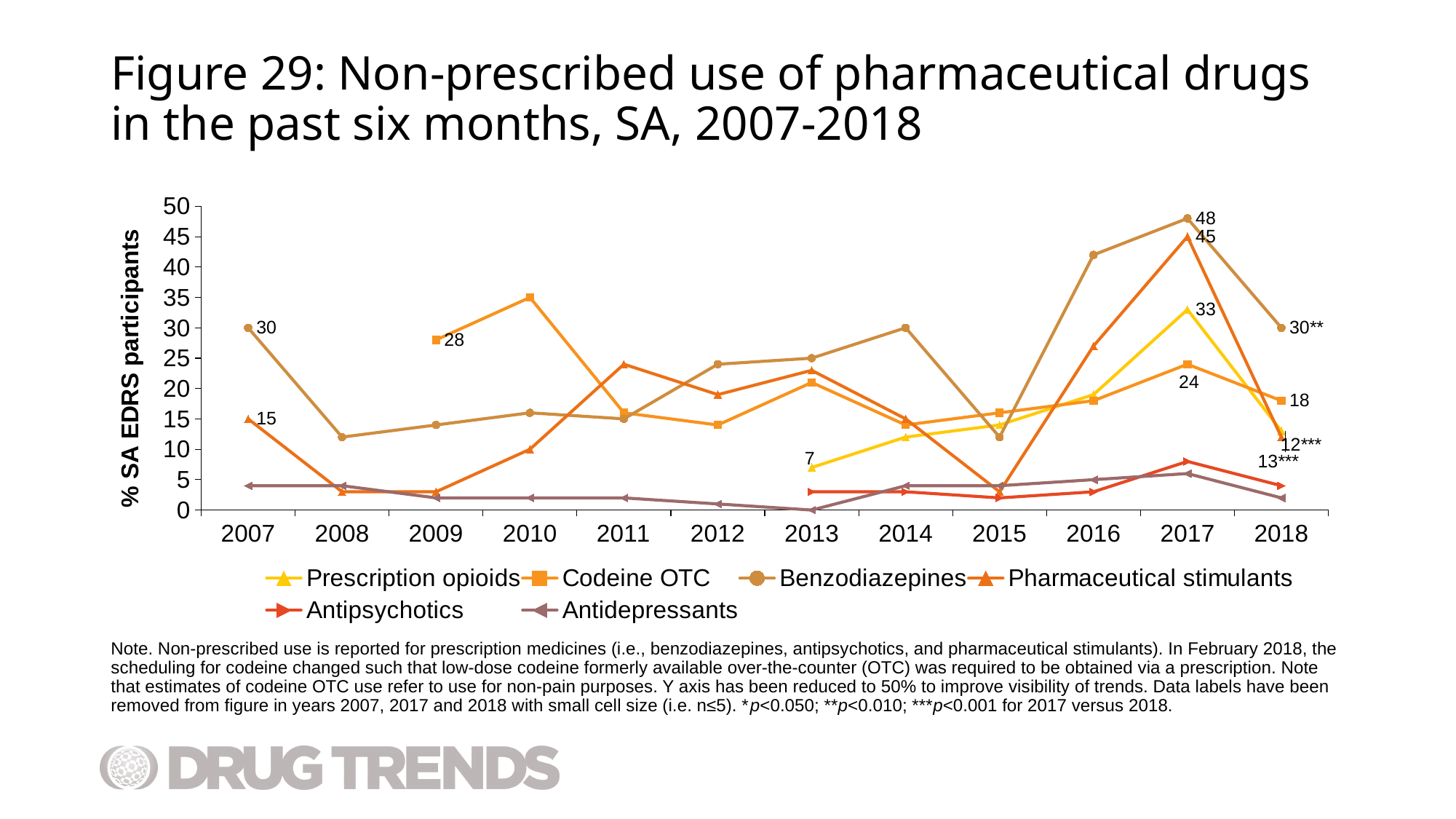
Which series had the highest value in 2017? Benzodiazepines What was the value for Pharmaceutical stimulants in 2017? 45 How many years are shown on the x axis? 12 What kind of chart is shown on the slide? Line chart What is the difference between the Codeine OTC values in 2017 and 2018? 6 What was the value for Prescription opioids in 2013? 7 Is the value for Benzodiazepines in 2016 greater or less than 40? greater What is the difference between the Benzodiazepines and Pharmaceutical stimulants values in 2017? 3 How many series does the legend list? 6 What was the value for Benzodiazepines in 2017? 48 What was the value for Prescription opioids in 2017? 33 What was the value for Codeine OTC in 2009? 28